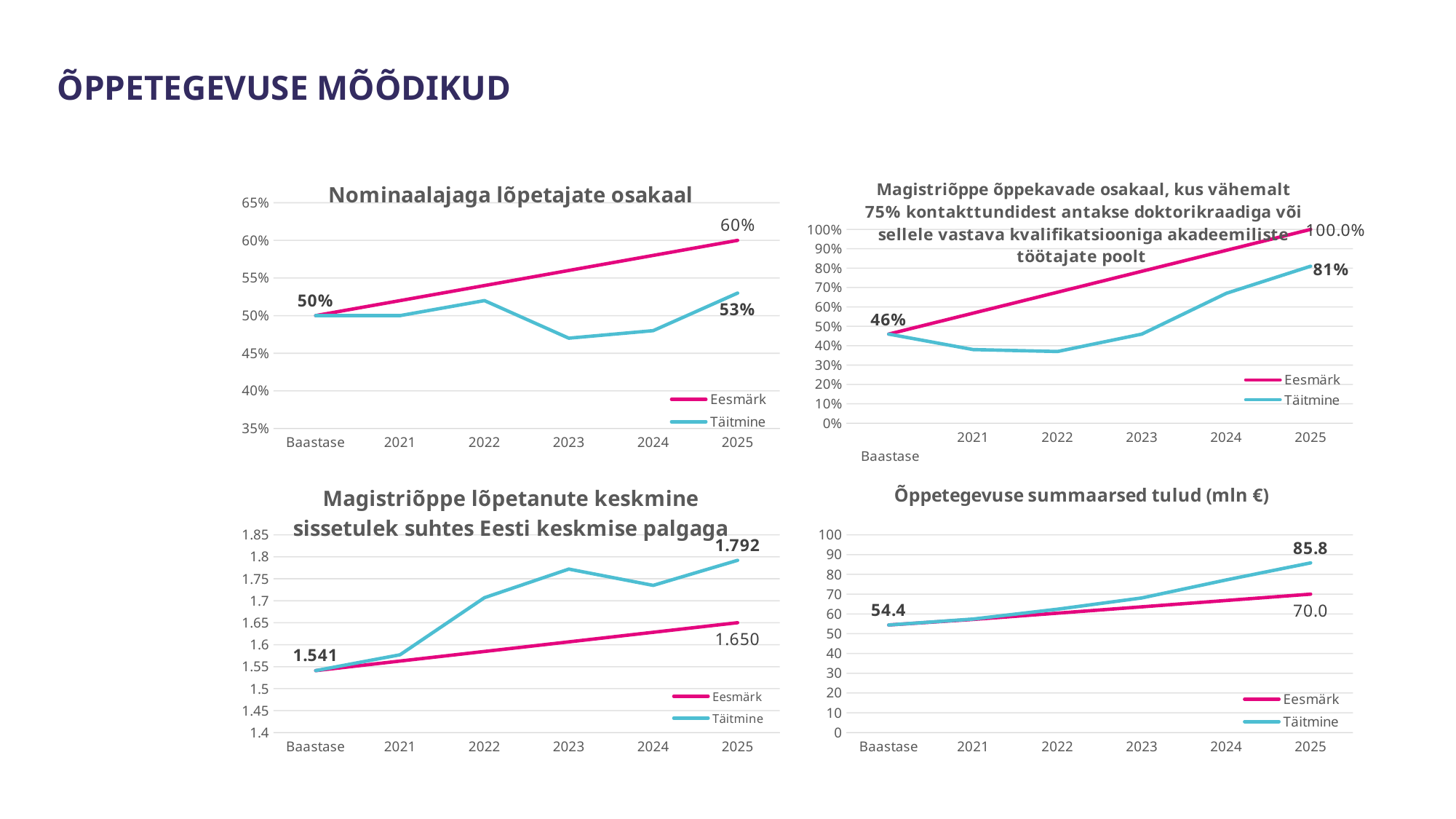
In the top-right chart (Magistriõppe õppekavade osakaal...), is the Täitmine value for 2022 greater or less than 40%? less In the chart titled "Õppetegevuse summaarsed tulud (mln €)", does the Eesmärk line rise or fall from Baastase to 2025? rise In the top-right chart (Magistriõppe õppekavade osakaal...), what is the Täitmine value for 2025? 81% In the chart titled "Nominaalajaga lõpetajate osakaal", is the Täitmine value for 2023 greater or less than 50%? less In the chart titled "Õppetegevuse summaarsed tulud (mln €)", what is the difference between the Täitmine and Eesmärk values for 2025? 15.8 In the chart titled "Magistriõppe lõpetanute keskmine sissetulek suhtes Eesti keskmise palgaga", which is larger in 2025, Eesmärk or Täitmine? Täitmine In the chart titled "Nominaalajaga lõpetajate osakaal", what is the difference between the Eesmärk and Täitmine values for 2025? 7 percentage points In the top-right chart (Magistriõppe õppekavade osakaal...), what is the Baastase value? 46% In the chart titled "Nominaalajaga lõpetajate osakaal", what is the Eesmärk value for 2025? 60% In the chart titled "Magistriõppe lõpetanute keskmine sissetulek suhtes Eesti keskmise palgaga", what is the Täitmine value for 2025? 1.792 How many series does the legend list in the chart titled "Õppetegevuse summaarsed tulud (mln €)"? 2 In the chart titled "Nominaalajaga lõpetajate osakaal", what is the Täitmine value for 2025? 53%